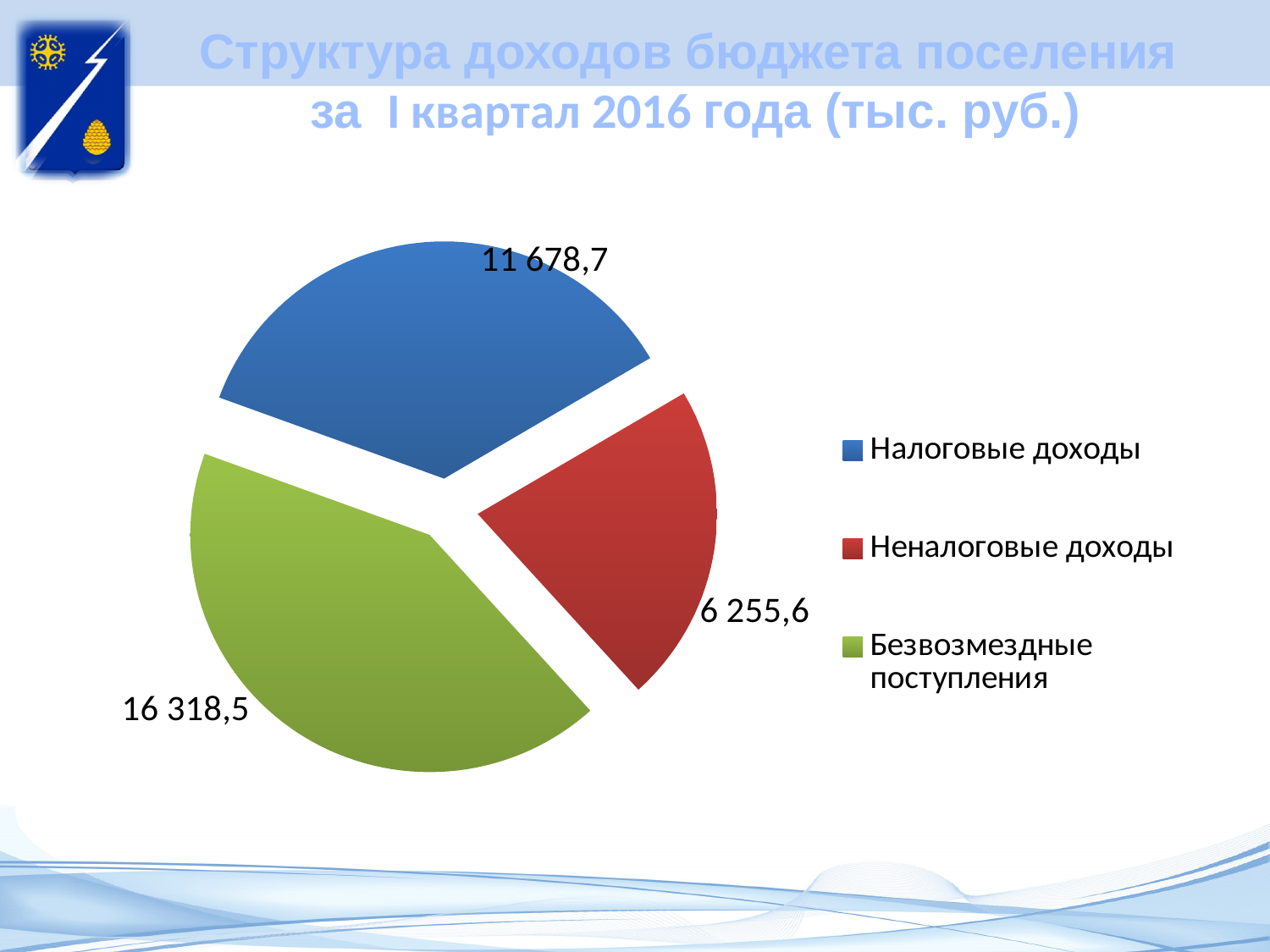
Which category has the smallest slice of the pie? Неналоговые доходы Which is larger, Налоговые доходы or Неналоговые доходы? Налоговые доходы Which category has the largest slice of the pie? Безвозмездные поступления What is the value for Налоговые доходы? 11 678,7 How many categories does the pie chart show? 3 What is the difference between Безвозмездные поступления and Налоговые доходы? 4 639,8 What is the value for Неналоговые доходы? 6 255,6 What type of chart is shown on the slide? pie chart What is the difference between Налоговые доходы and Неналоговые доходы? 5 423,1 What colour is the slice for Безвозмездные поступления? green What is the total of all three slices of the pie? 34 252,8 What is the value for Безвозмездные поступления? 16 318,5